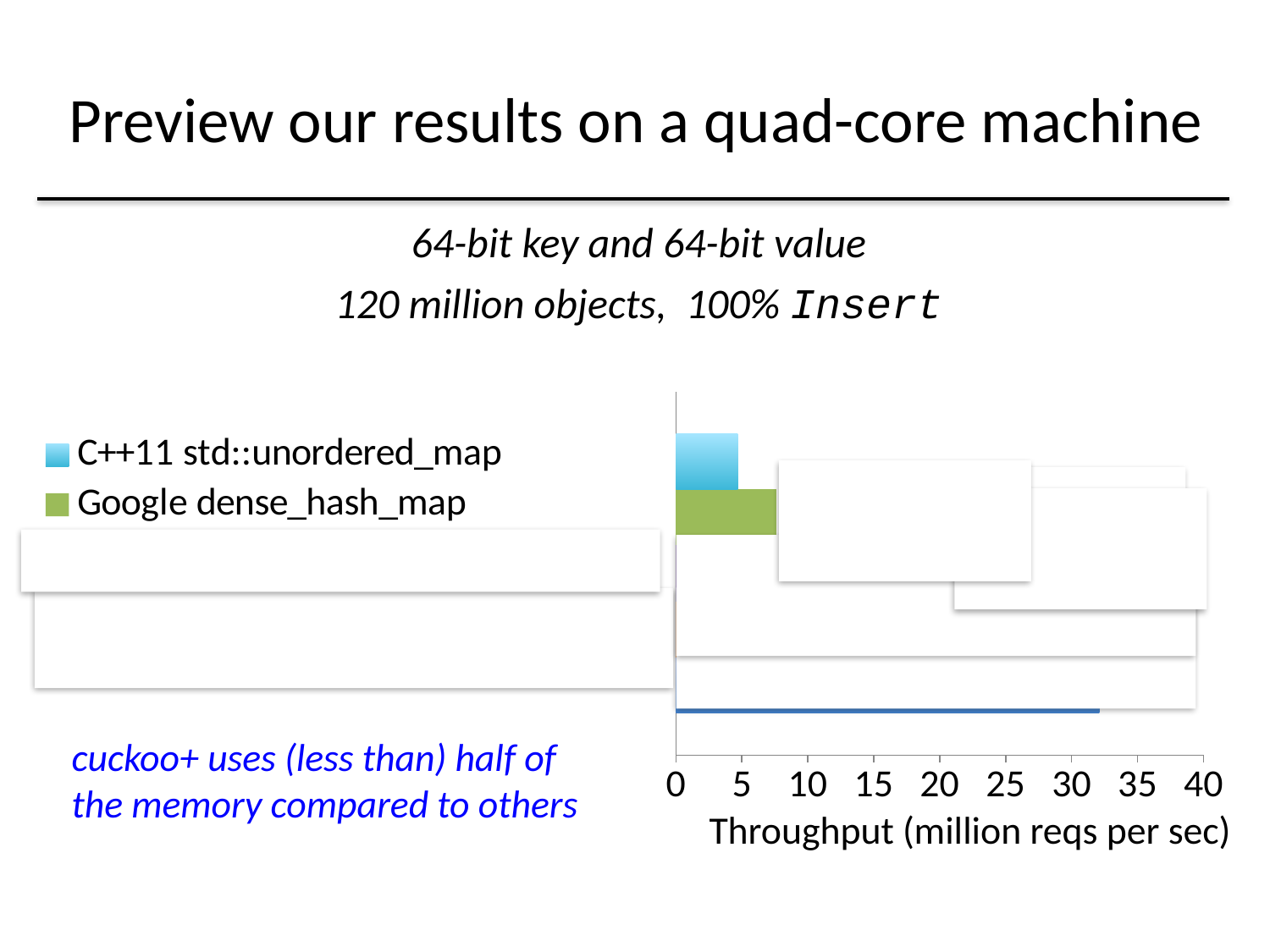
What kind of chart is shown on the slide? bar chart What is the highest value shown on the horizontal axis? 40 What is the title of the horizontal axis of the chart? Throughput (million reqs per sec) Is the throughput for C++11 std::unordered_map greater or less than 10? less Is the throughput for Google dense_hash_map greater or less than 10? less Is the throughput for Google dense_hash_map greater or less than 5? greater Which has the higher throughput, C++11 std::unordered_map or Google dense_hash_map? Google dense_hash_map Which legend entry is shown in light blue? C++11 std::unordered_map